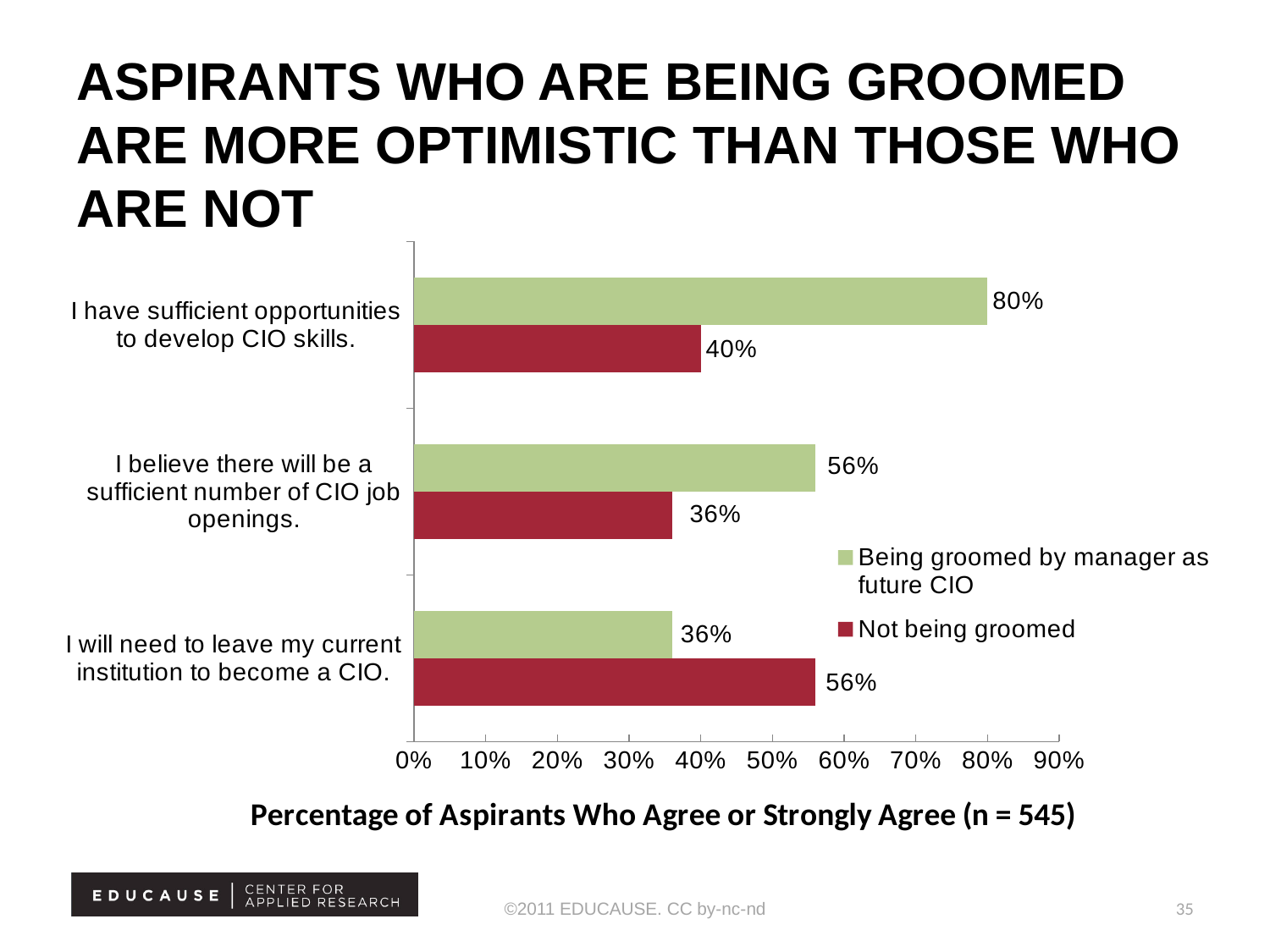
How many statements are shown on the chart? 3 Which statement has the highest value for the 'Being groomed by manager as future CIO' series? I have sufficient opportunities to develop CIO skills. What kind of chart is shown on the slide? Bar chart What percentage of aspirants not being groomed agree that they have sufficient opportunities to develop CIO skills? 40% What is the value for 'Being groomed by manager as future CIO' on the statement 'I will need to leave my current institution to become a CIO'? 36% For 'I will need to leave my current institution to become a CIO', which group has the larger value: being groomed or not being groomed? Not being groomed What is the x-axis title of the chart? Percentage of Aspirants Who Agree or Strongly Agree (n = 545) What is the difference between the groomed and not-groomed values for 'I have sufficient opportunities to develop CIO skills'? 40% What is the value for 'Not being groomed' on the statement 'I believe there will be a sufficient number of CIO job openings'? 36% How many series does the legend list? 2 Which statement has the lowest value for the 'Not being groomed' series? I believe there will be a sufficient number of CIO job openings. What percentage of aspirants being groomed by their manager as future CIO agree that they have sufficient opportunities to develop CIO skills? 80%